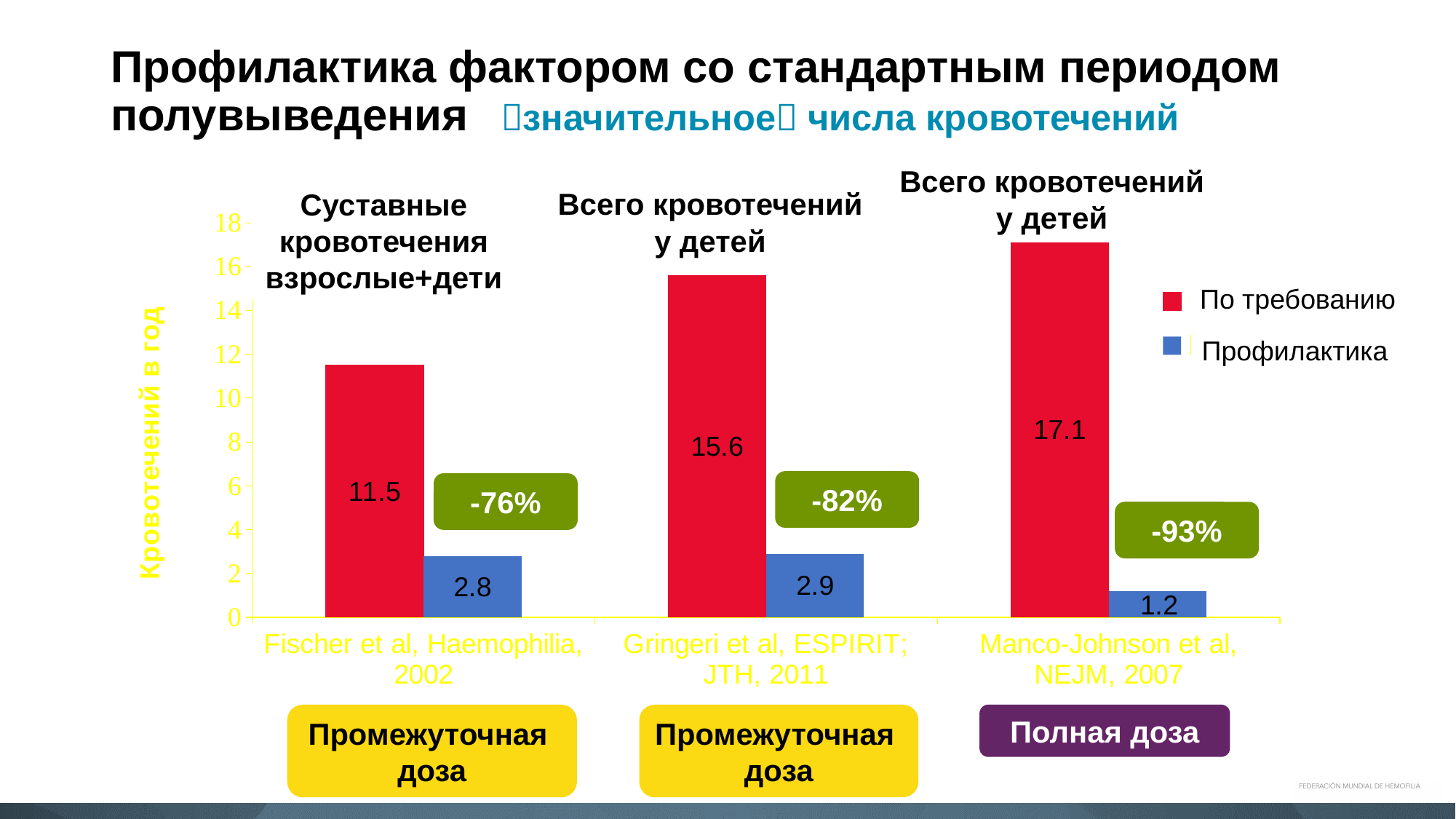
What is the value for По требованию in the Manco-Johnson et al, NEJM, 2007 study? 17.1 What is the value for Профилактика in the Gringeri et al, ESPIRIT; JTH, 2011 study? 2.9 What is the value for По требованию in the Fischer et al, Haemophilia, 2002 study? 11.5 How many series does the legend list? 2 What is the difference between По требованию and Профилактика in the Fischer et al, Haemophilia, 2002 study? 8.7 What is the value for Профилактика in the Manco-Johnson et al, NEJM, 2007 study? 1.2 Which study has the lowest value for Профилактика? Manco-Johnson et al, NEJM, 2007 Which is larger: По требованию for Gringeri et al, ESPIRIT; JTH, 2011 or По требованию for Fischer et al, Haemophilia, 2002? Gringeri et al, ESPIRIT; JTH, 2011 What is the label of the y axis? Кровотечений в год Which study has the highest value for По требованию? Manco-Johnson et al, NEJM, 2007 What type of chart is shown on the slide? bar chart How many studies (categories) are shown on the x axis? 3